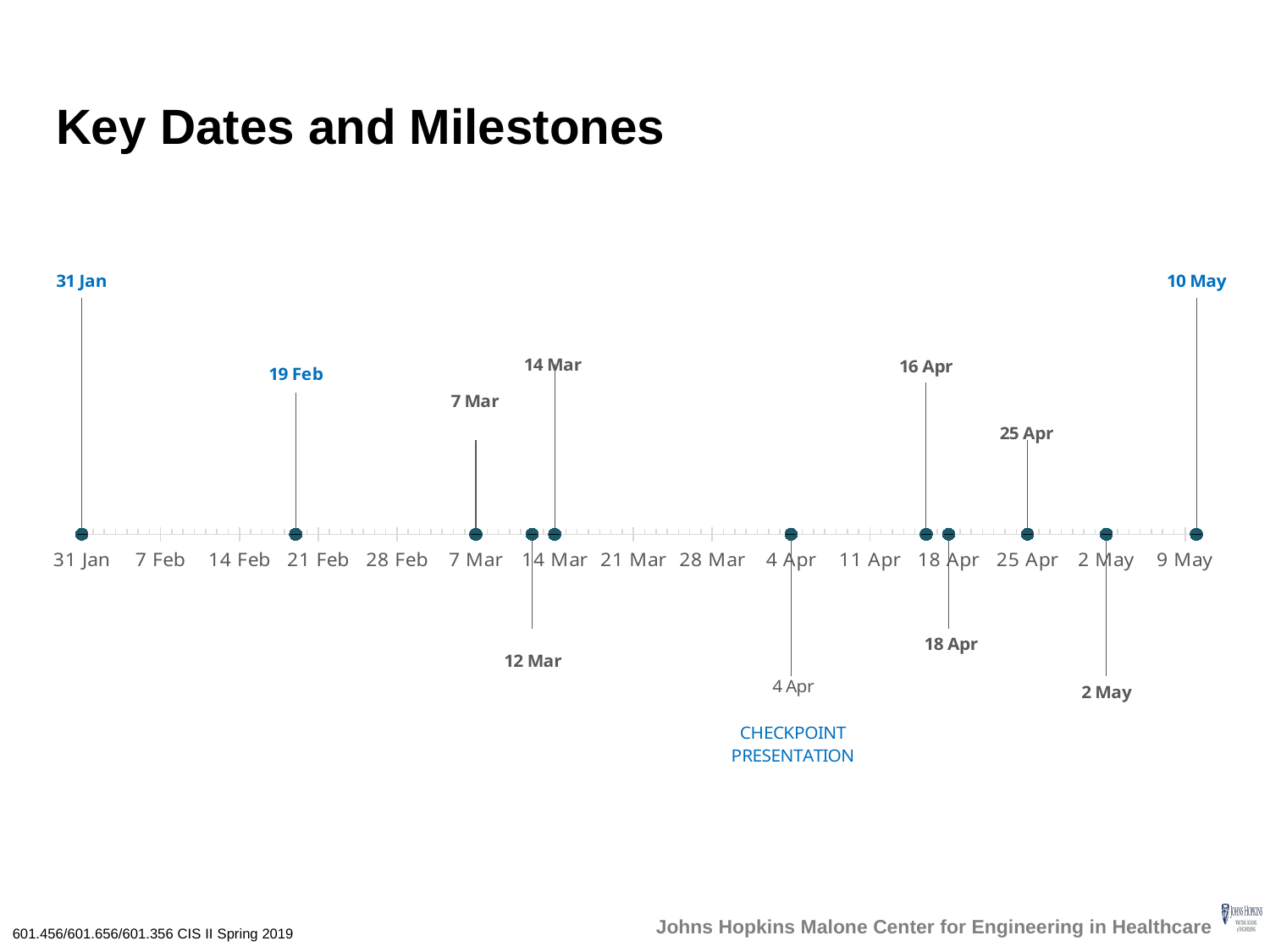
How many milestones fall in April on the timeline? 4 How many milestones fall in March on the timeline? 3 What kind of chart is shown on the slide? Timeline chart Which milestone comes first, 12 Mar or 14 Mar? 12 Mar What is the title of the chart on the slide? Key Dates and Milestones What is the latest milestone date shown on the timeline? 10 May Which milestone date is labelled "CHECKPOINT PRESENTATION"? 4 Apr What is the first date label on the x axis of the timeline? 31 Jan What is the earliest milestone date shown on the timeline? 31 Jan What is the last date label on the x axis of the timeline? 9 May Which milestone is plotted between 16 Apr and 25 Apr on the timeline? 18 Apr How many milestone markers are plotted on the timeline? 11